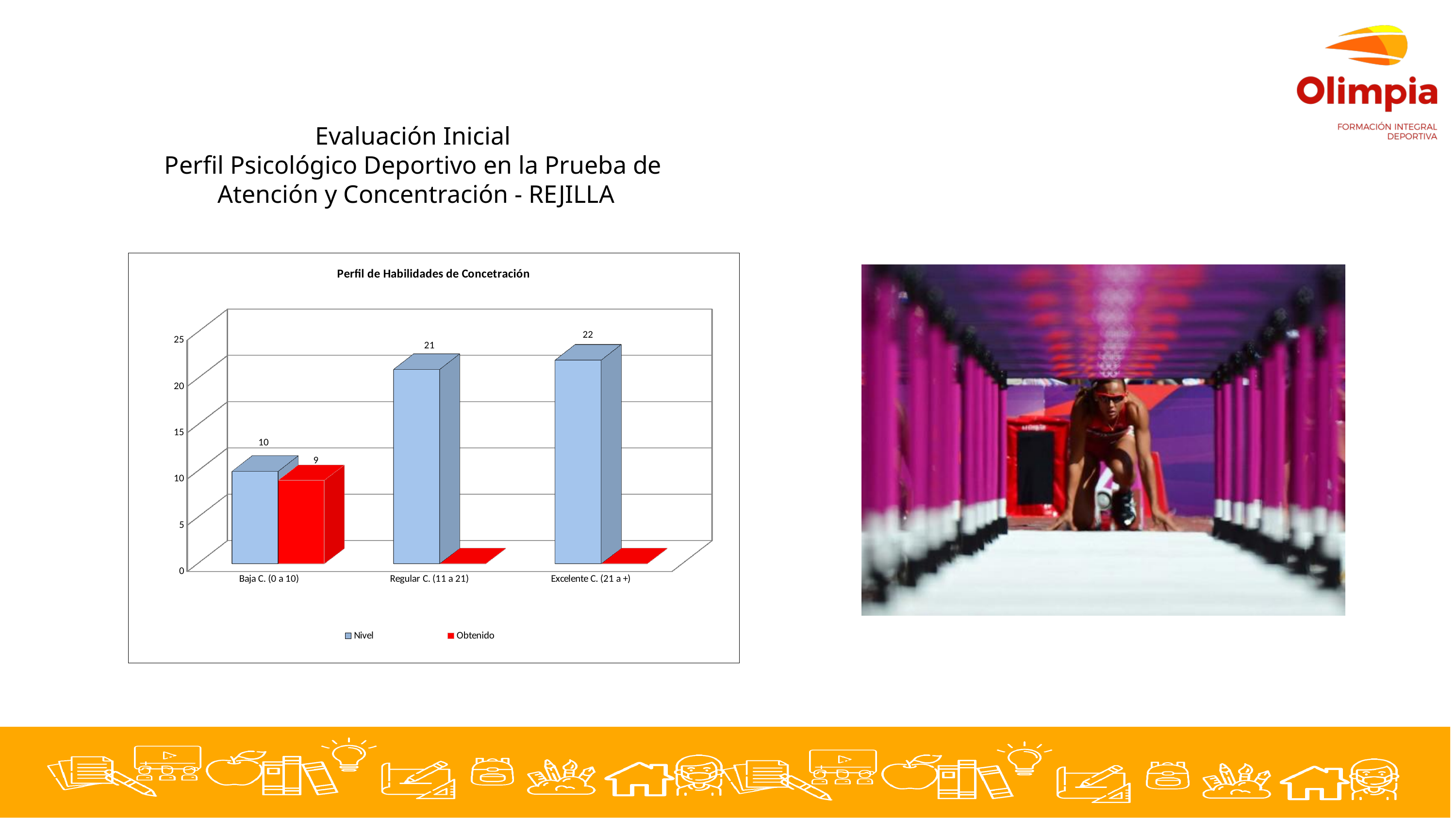
Is the Nivel value for Regular C. (11 a 21) greater or less than 15? greater For Baja C. (0 a 10), which is larger: the Nivel value or the Obtenido value? Nivel What is the Nivel value for Excelente C. (21 a +)? 22 What is the difference between the Nivel values for Regular C. (11 a 21) and Baja C. (0 a 10)? 11 Which category has the highest Nivel value? Excelente C. (21 a +) How many series does the legend list? 2 What is the Obtenido value for Baja C. (0 a 10)? 9 What is the Nivel value for Regular C. (11 a 21)? 21 What is the Nivel value for Baja C. (0 a 10)? 10 How many categories are shown on the x axis? 3 Which category has the lowest Nivel value? Baja C. (0 a 10) What is the title of the chart? Perfil de Habilidades de Concetración